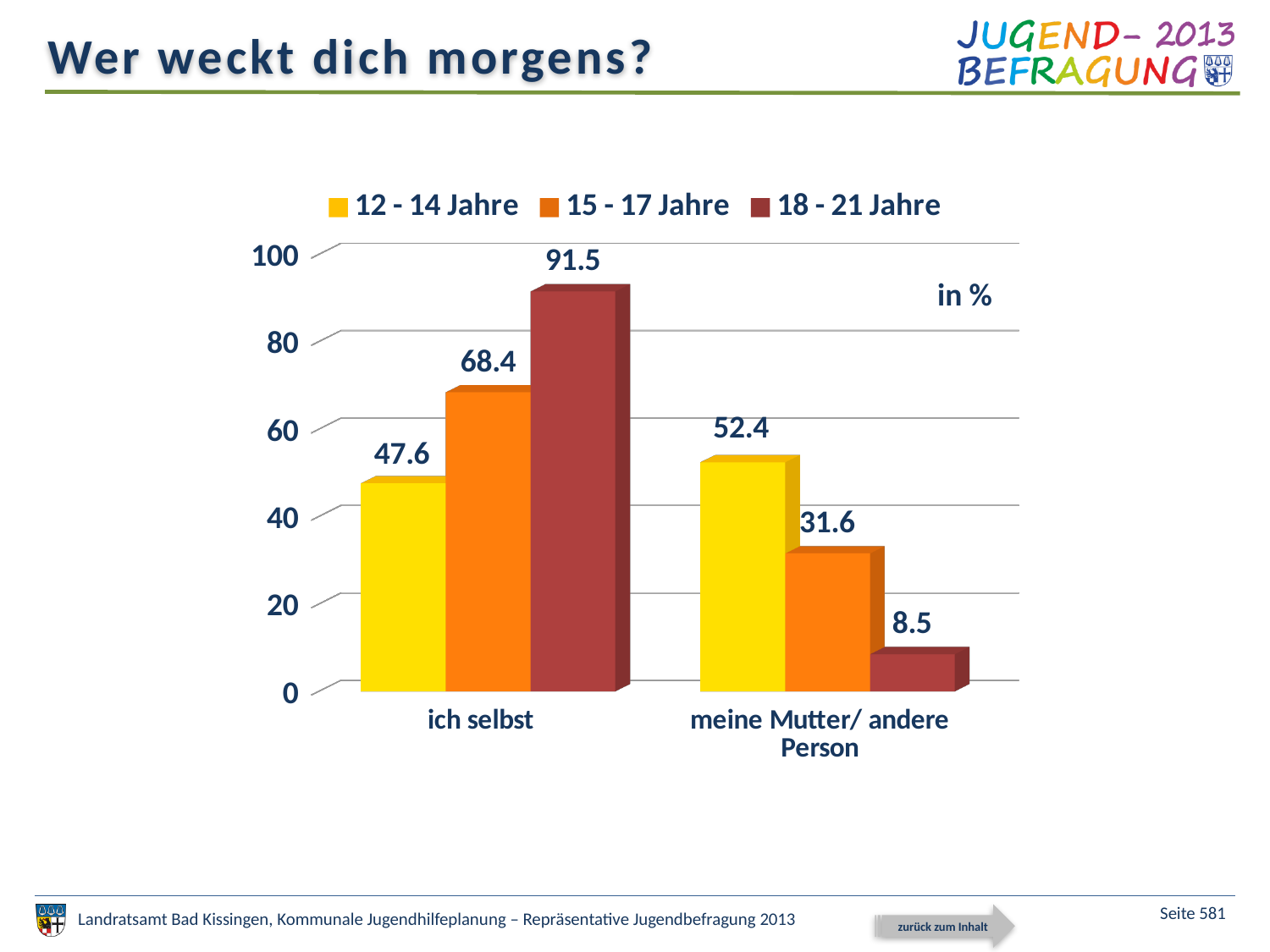
What unit is indicated for the values in the chart? in % How many series does the legend list? 3 What is the value for the 12 - 14 Jahre series in the 'meine Mutter/ andere Person' category? 52.4 What is the difference between the 18 - 21 Jahre values for 'ich selbst' and 'meine Mutter/ andere Person'? 83 What is the value for the 15 - 17 Jahre series in the 'ich selbst' category? 68.4 How many categories are shown on the x axis? 2 Is the value for 15 - 17 Jahre in the 'meine Mutter/ andere Person' category greater or less than 40? less Which age group has the highest value in the 'ich selbst' category? 18 - 21 Jahre Which is larger: the 12 - 14 Jahre value for 'ich selbst' or for 'meine Mutter/ andere Person'? meine Mutter/ andere Person Which age group has the lowest value in the 'meine Mutter/ andere Person' category? 18 - 21 Jahre What kind of chart is shown on the slide? bar chart What is the value for the 18 - 21 Jahre series in the 'ich selbst' category? 91.5